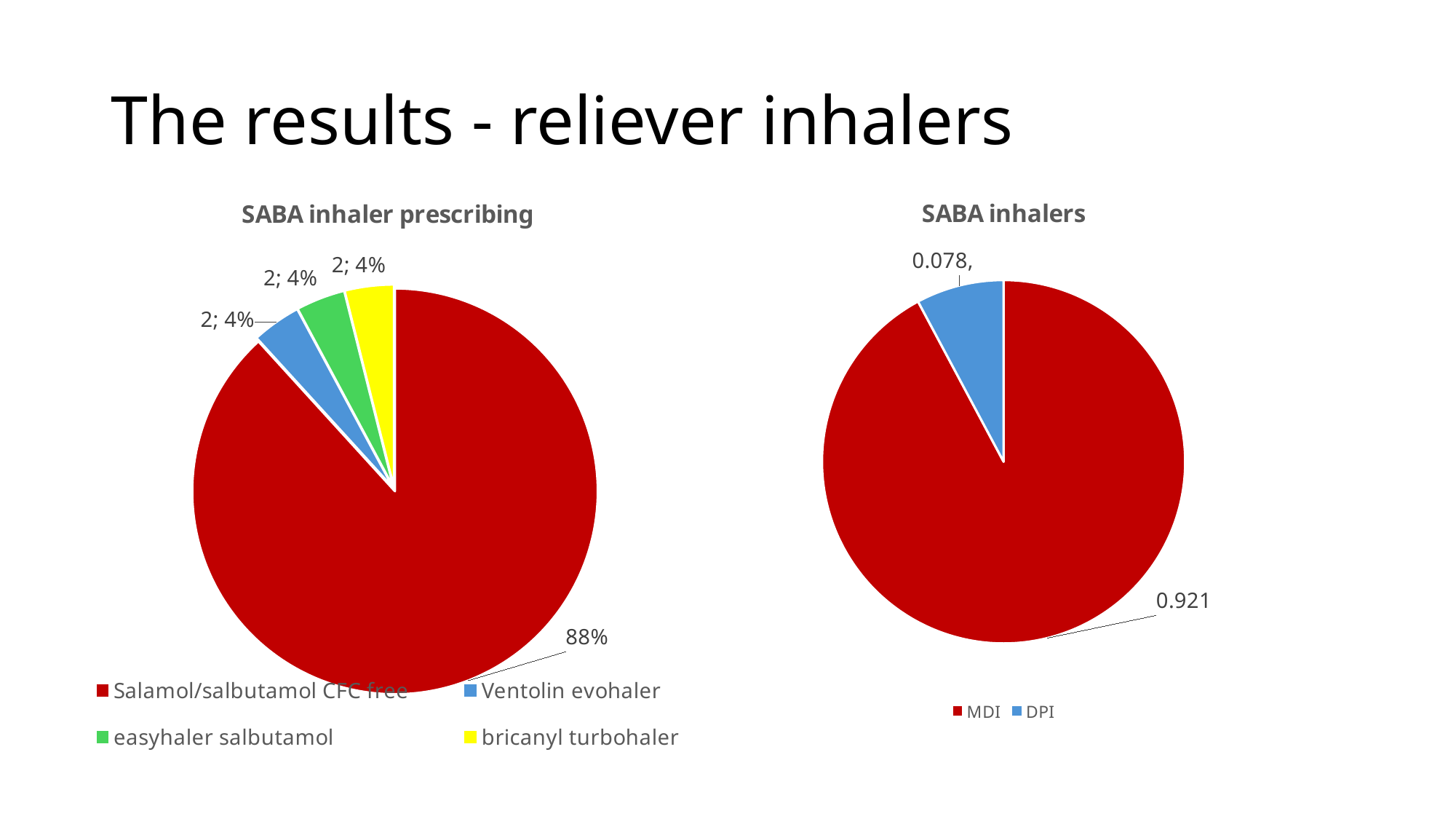
In the 'SABA inhaler prescribing' chart, how many categories does the legend list? 4 In the 'SABA inhalers' chart, what is the value shown for DPI? 0.078 In the 'SABA inhalers' chart, which is larger, MDI or DPI? MDI In the 'SABA inhaler prescribing' chart, what is the data label shown for Ventolin evohaler? 2; 4% In the 'SABA inhalers' chart, what is the value shown for MDI? 0.921 In the 'SABA inhalers' chart, what is the difference between the MDI and DPI values? 0.843 What kind of chart is 'SABA inhaler prescribing'? Pie chart In the 'SABA inhaler prescribing' chart, what colour is the bricanyl turbohaler slice? Yellow In the 'SABA inhaler prescribing' chart, which category has the largest slice? Salamol/salbutamol CFC free In the 'SABA inhaler prescribing' chart, what percentage share does Salamol/salbutamol CFC free have? 88% In the 'SABA inhalers' chart, how many categories does the legend list? 2 In the 'SABA inhalers' chart, which category has the smallest slice? DPI